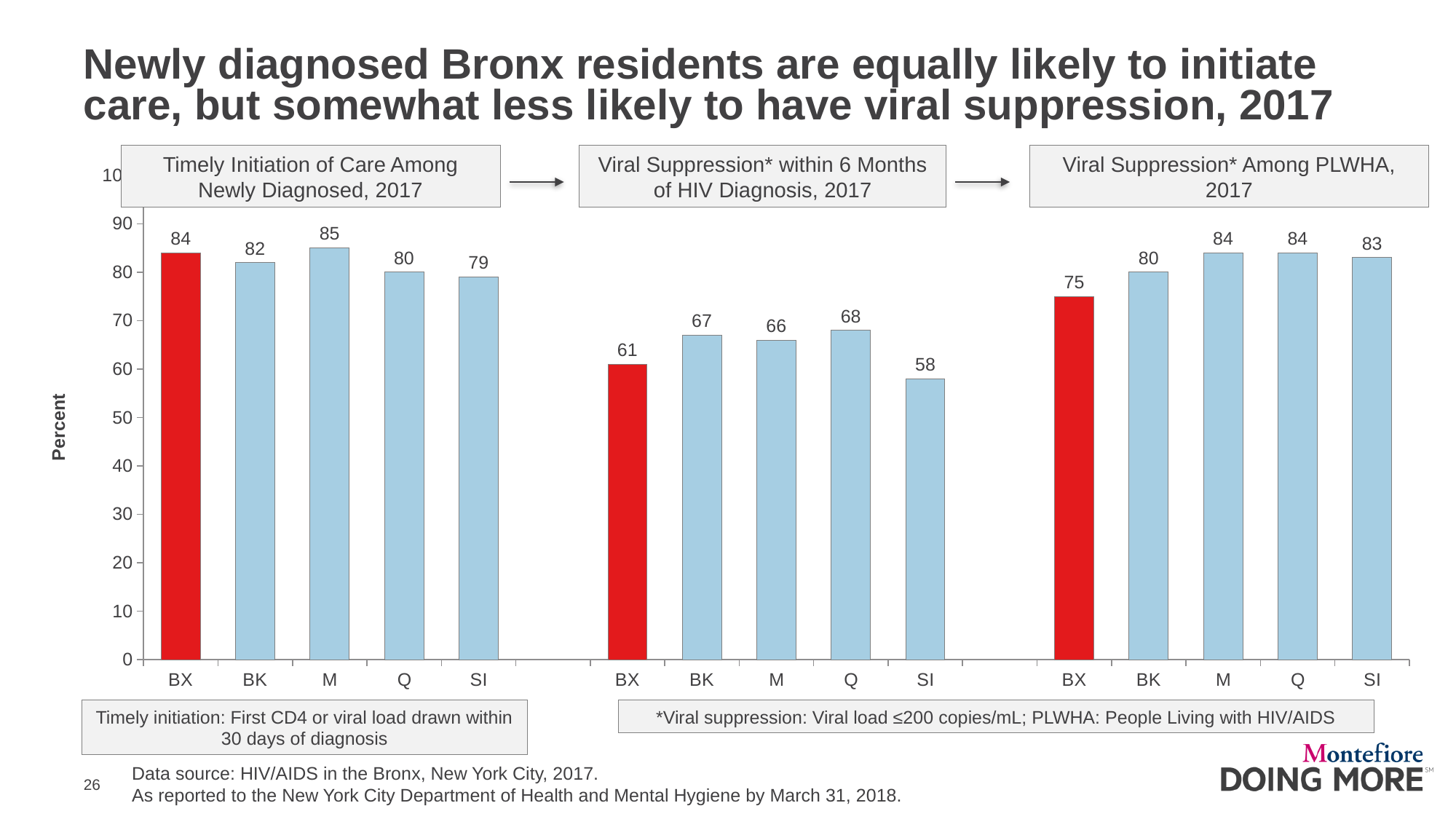
In the "Viral Suppression* Among PLWHA, 2017" section, what is the difference between the values for M and BX? 9 What is the label on the vertical axis of the chart? Percent What type of chart is shown on the slide? Bar chart In the "Timely Initiation of Care Among Newly Diagnosed, 2017" section, which borough has the highest value? M How many bars are plotted in the "Viral Suppression* Among PLWHA, 2017" section? 5 In the "Viral Suppression* within 6 Months of HIV Diagnosis, 2017" section, which is larger, the value for BK or the value for Q? Q In the "Timely Initiation of Care Among Newly Diagnosed, 2017" section, what is the value for BX? 84 In the "Viral Suppression* within 6 Months of HIV Diagnosis, 2017" section, what is the value for SI? 58 What is the difference between the BX value in the "Timely Initiation of Care" section and the BX value in the "Viral Suppression* within 6 Months" section? 23 In the "Viral Suppression* Among PLWHA, 2017" section, which borough has the lowest value? BX In the "Viral Suppression* within 6 Months of HIV Diagnosis, 2017" section, which borough has the lowest value? SI In the "Viral Suppression* Among PLWHA, 2017" section, what is the value for BX? 75